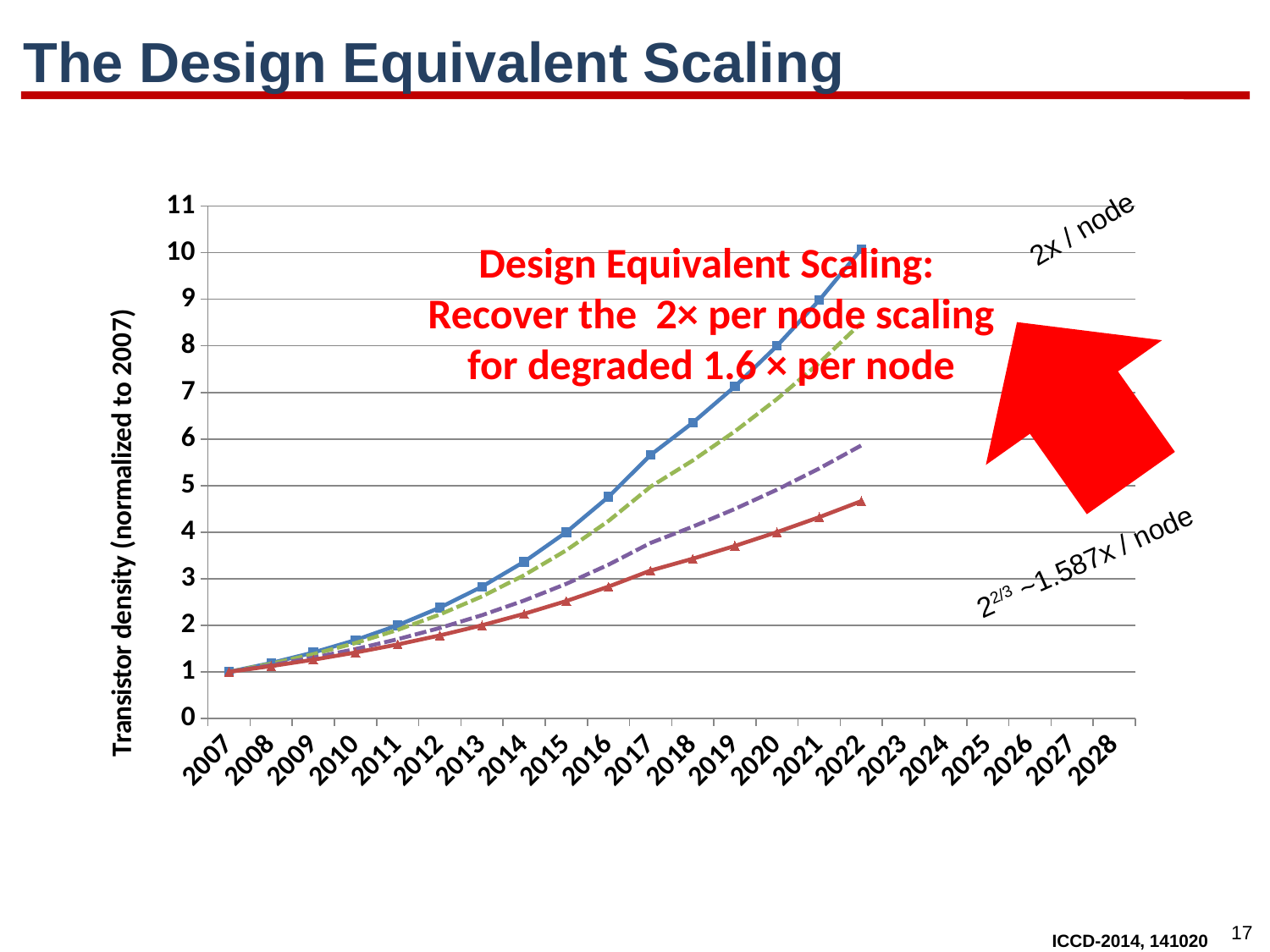
How many lines are plotted on the chart? 4 What kind of chart is shown on the slide? line chart In 2022, which is larger: the 2x / node line or the 1.587x / node line? the 2x / node line Is the value of the 1.587x / node line in 2018 greater or less than 4? less How many year labels are shown along the x axis? 22 What scaling factor per node is written next to the lowest line? 2^(2/3) ~1.587x / node What is the title of the vertical axis? Transistor density (normalized to 2007) Do the lines rise or fall from 2007 to 2022? rise What is the value of the lines in 2007? 1 Which line reaches the highest value in 2022? the 2x / node line Is the value of the 1.587x / node line in 2022 greater or less than 5? less Is the value of the 2x / node line in 2021 greater or less than 8? greater